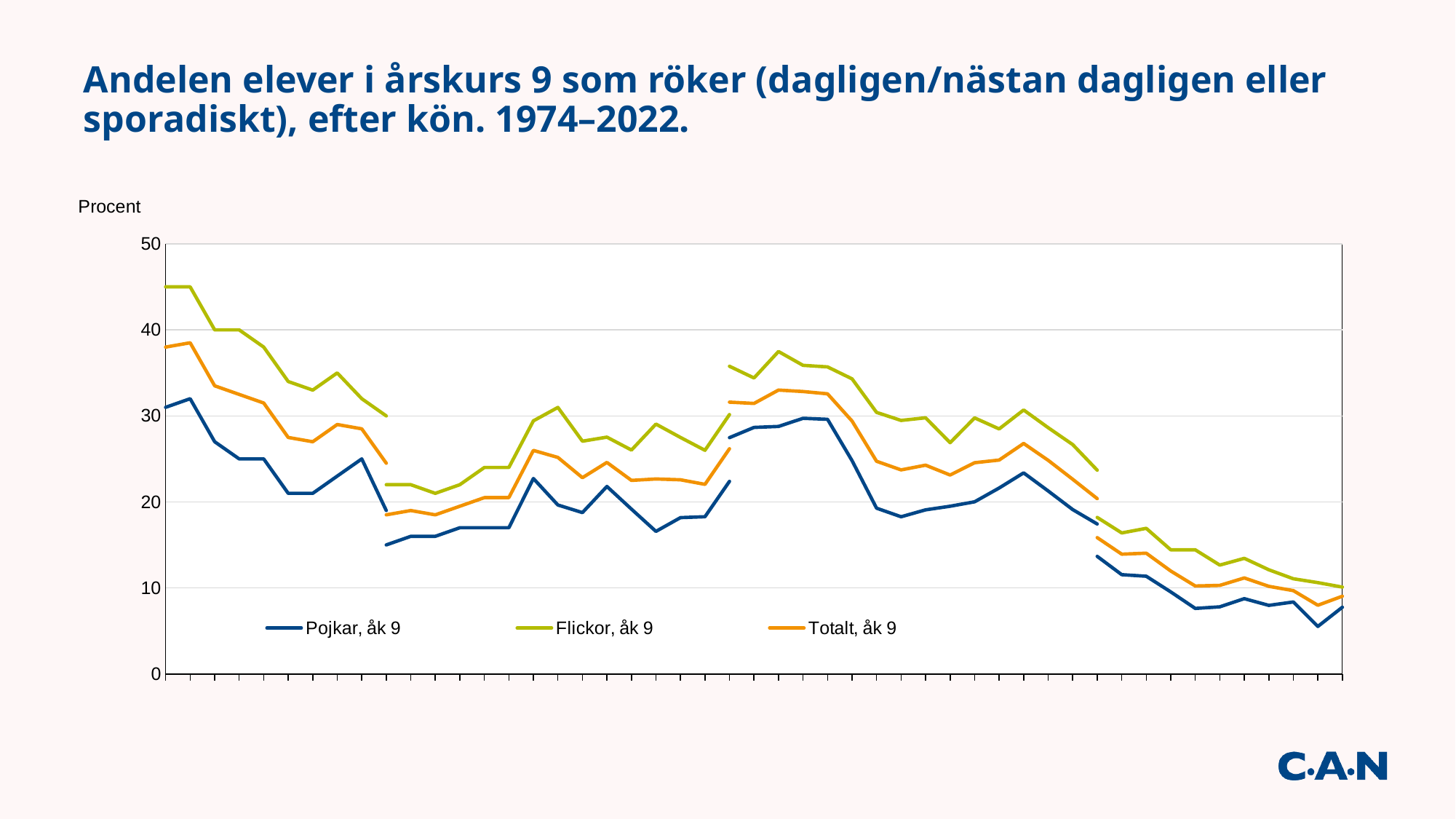
Do the values generally rise or fall from the left of the chart (1974) to the right (2022)? fall Is the value for Flickor, åk 9 at the first point of the chart (1974) greater or less than 40? greater At the first point of the chart (1974), which series is higher: Pojkar, åk 9 or Flickor, åk 9? Flickor, åk 9 Which series lies lowest across most of the chart? Pojkar, åk 9 What kind of chart is shown on the slide? line chart Which series has the highest value at the first point of the chart (1974)? Flickor, åk 9 What are the three series named in the legend? Pojkar, åk 9; Flickor, åk 9; Totalt, åk 9 Is the value for Pojkar, åk 9 at the first point of the chart (1974) greater or less than 40? less Is the value for Totalt, åk 9 at the first point of the chart (1974) greater or less than 30? greater How many series does the legend list? 3 What is the label on the vertical axis of the chart? Procent